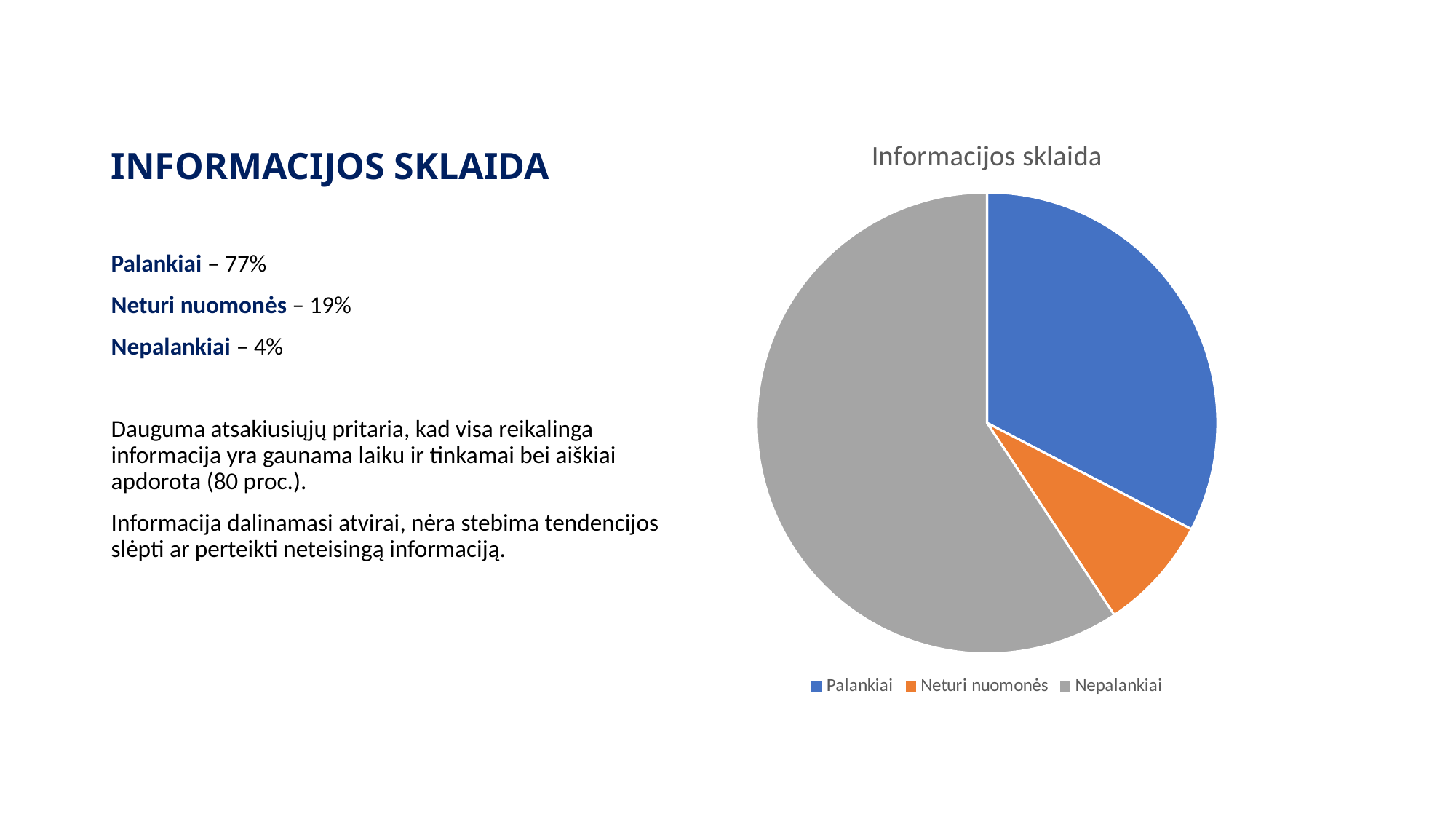
Which slice of the pie chart is the largest? Nepalankiai Which slice of the pie chart is the smallest? Neturi nuomonės What colour is the Neturi nuomonės slice in the pie chart? orange What kind of chart is shown on the slide? pie chart In the pie chart, which slice is larger: Palankiai or Neturi nuomonės? Palankiai How many slices does the pie chart have? 3 In the pie chart, which slice is larger: Nepalankiai or Palankiai? Nepalankiai What is the title of the chart? Informacijos sklaida How many entries does the chart legend list? 3